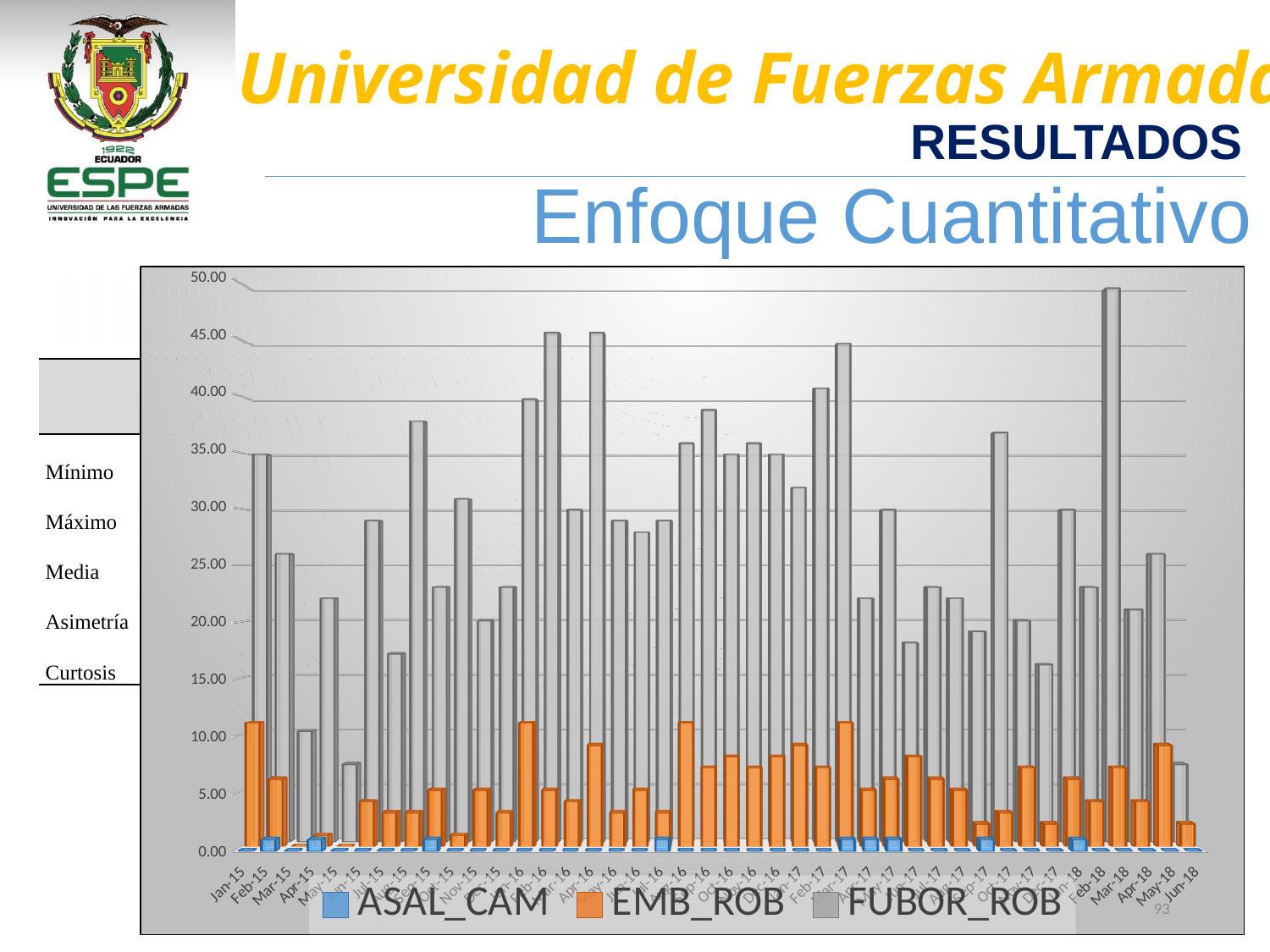
Is the EMB_ROB value for Jan-15 greater or less than 5? greater Which series is shown in gray in the chart? FUBOR_ROB Is the FUBOR_ROB value for Jan-15 greater or less than 30? greater Which series has the lowest values across the chart? ASAL_CAM Which series is shown in orange in the chart? EMB_ROB Which is larger, the FUBOR_ROB value for Jan-15 or for Feb-15? Jan-15 What kind of chart is shown on the slide? bar chart Is the FUBOR_ROB value for Jun-18 greater or less than 10? less In which month does FUBOR_ROB reach its highest value? Mar-18 How many series does the chart legend list? 3